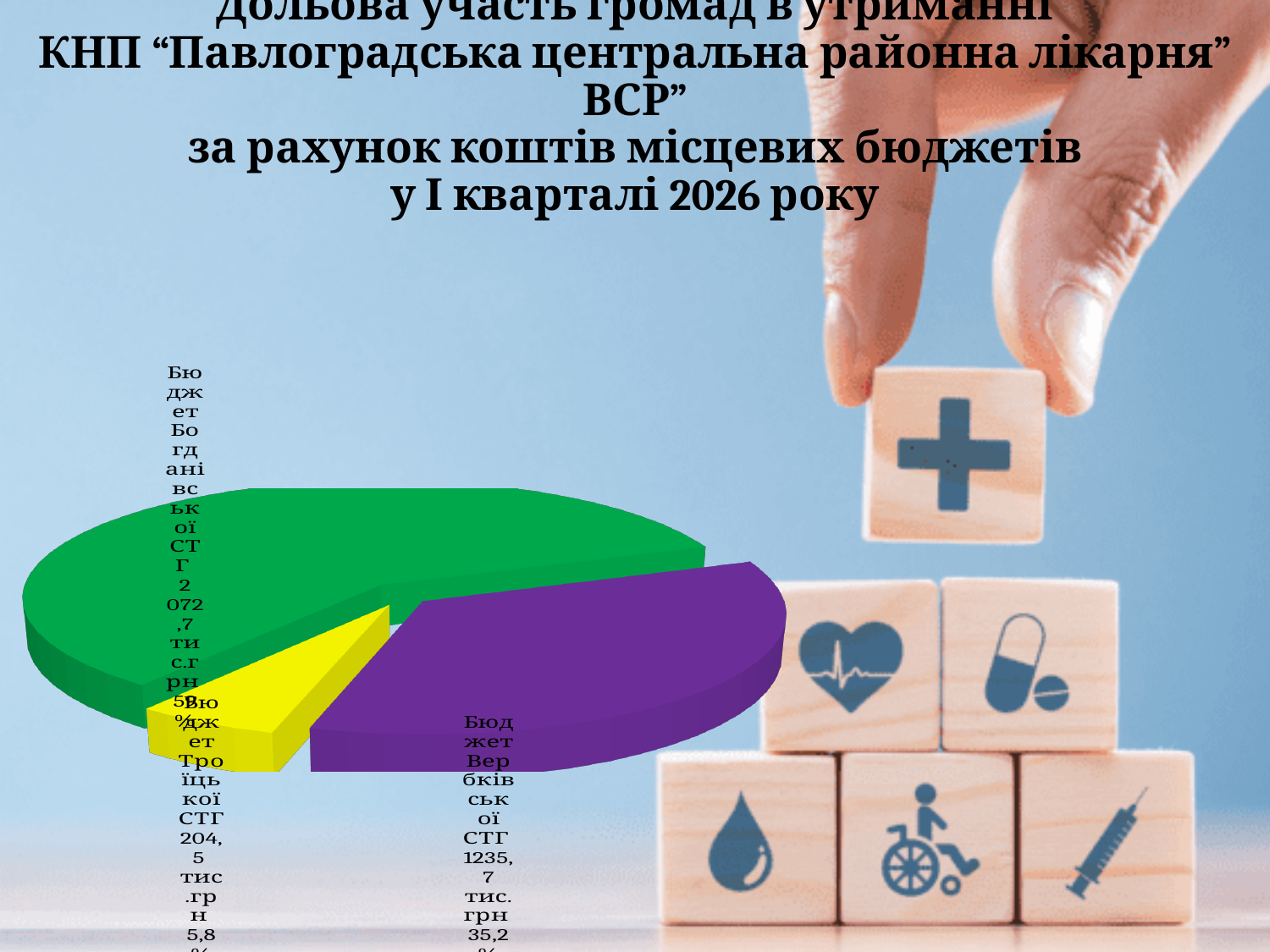
What amount is shown for Бюджет Богданівської СТГ? 2072,7 тис.грн Which is larger, the amount for Бюджет Вербківської СТГ or for Бюджет Троїцької СТГ? Бюджет Вербківської СТГ What amount is shown for Бюджет Вербківської СТГ? 1235,7 тис.грн What is the difference between the amounts for Бюджет Богданівської СТГ and Бюджет Вербківської СТГ? 837,0 тис.грн What colour is the slice for Бюджет Вербківської СТГ? Purple Which budget has the largest slice of the pie chart? Бюджет Богданівської СТГ Which budget has the smallest slice of the pie chart? Бюджет Троїцької СТГ How many slices does the pie chart have? 3 What kind of chart is shown on the slide? Pie chart What share of the pie does Бюджет Троїцької СТГ represent? 5,8% What amount is shown for Бюджет Троїцької СТГ? 204,5 тис.грн What share of the pie does Бюджет Вербківської СТГ represent? 35,2%